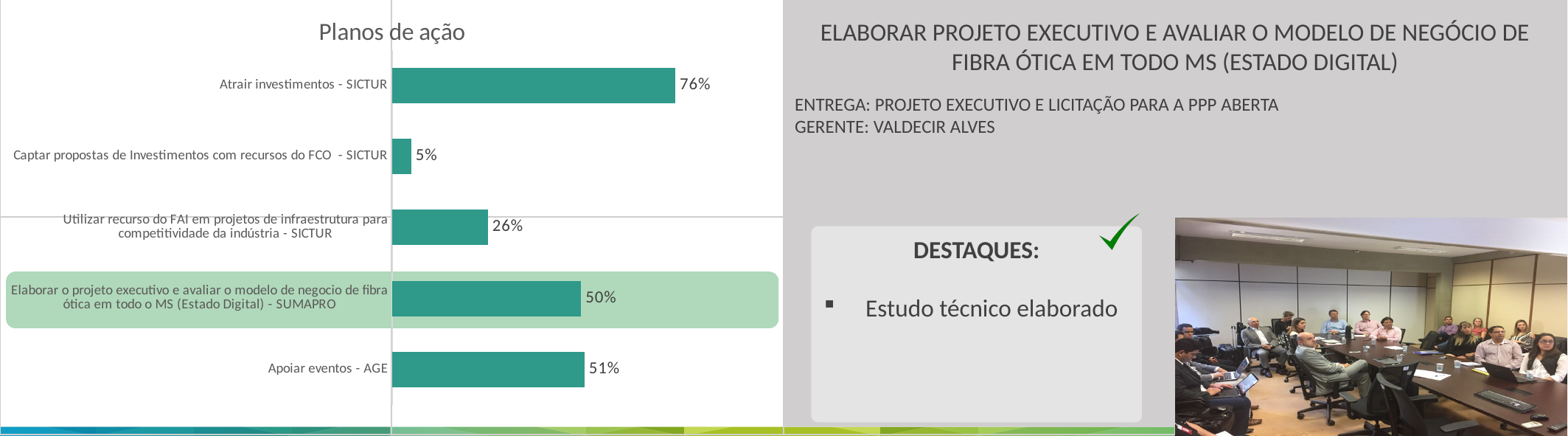
What is the title of the chart on the left of the slide? Planos de ação What is the value for 'Elaborar o projeto executivo e avaliar o modelo de negocio de fibra ótica em todo o MS (Estado Digital) - SUMAPRO'? 50% Which category has the lowest value in the 'Planos de ação' chart? Captar propostas de Investimentos com recursos do FCO - SICTUR What kind of chart is 'Planos de ação'? Bar chart What is the value for 'Captar propostas de Investimentos com recursos do FCO - SICTUR'? 5% Which category has the highest value in the 'Planos de ação' chart? Atrair investimentos - SICTUR What is the difference between the values for 'Atrair investimentos - SICTUR' and 'Utilizar recurso do FAI em projetos de infraestrutura para competitividade da indústria - SICTUR'? 50% Which is larger: the value for 'Apoiar eventos - AGE' or the value for 'Utilizar recurso do FAI em projetos de infraestrutura para competitividade da indústria - SICTUR'? Apoiar eventos - AGE How many categories are shown in the 'Planos de ação' chart? 5 Which category in the 'Planos de ação' chart is highlighted with a light green background? Elaborar o projeto executivo e avaliar o modelo de negocio de fibra ótica em todo o MS (Estado Digital) - SUMAPRO What is the value for 'Atrair investimentos - SICTUR' in the 'Planos de ação' chart? 76% What is the value for 'Apoiar eventos - AGE' in the 'Planos de ação' chart? 51%